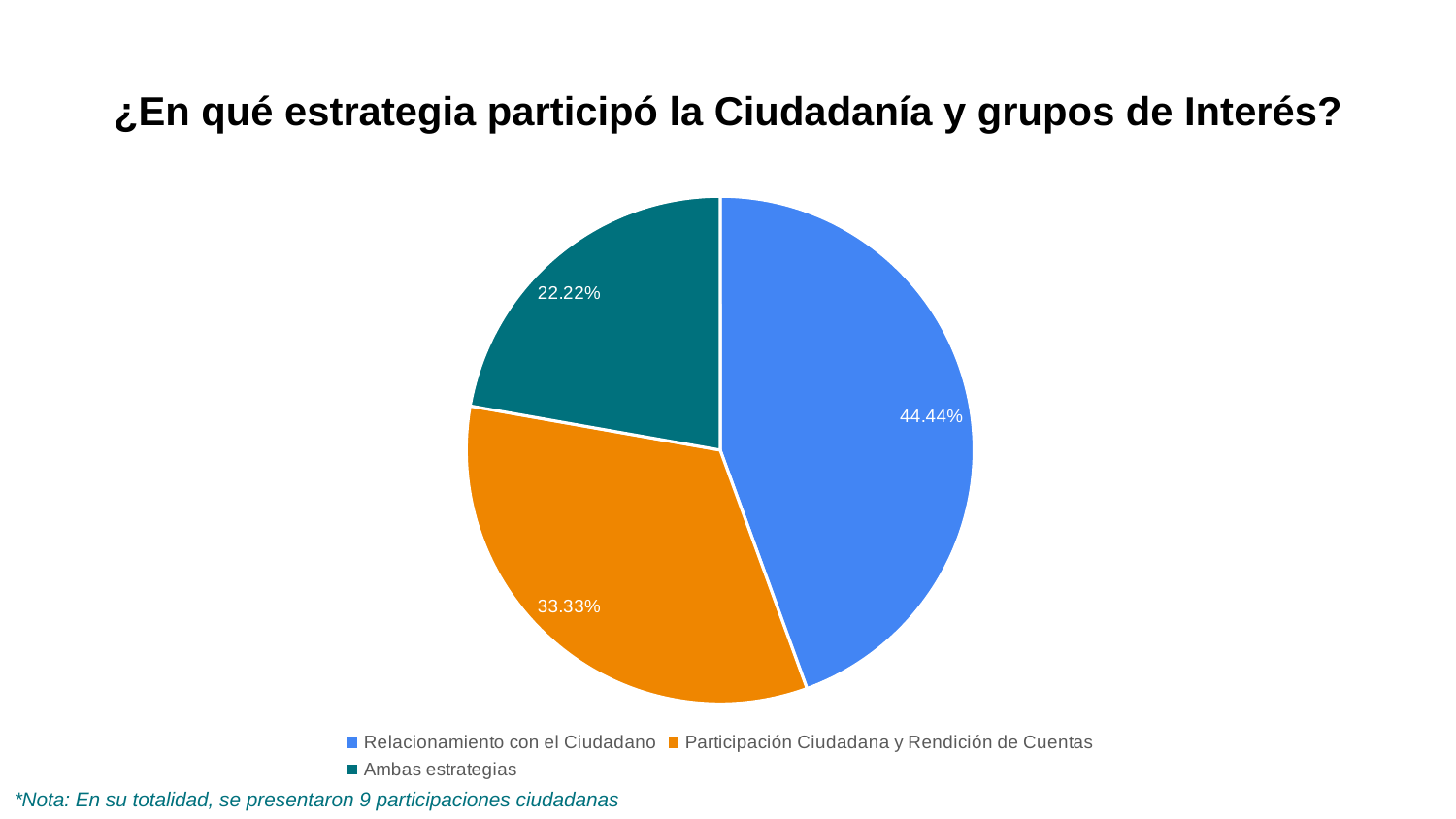
What colour is the slice for "Ambas estrategias"? Teal (dark green) How many categories does the pie chart show? 3 What share of the pie does "Relacionamiento con el Ciudadano" represent? 44.44% What is the difference in percentage points between "Relacionamiento con el Ciudadano" and "Ambas estrategias"? 22.22 What is the title of the chart? ¿En qué estrategia participó la Ciudadanía y grupos de Interés? What is the difference in percentage points between "Participación Ciudadana y Rendición de Cuentas" and "Ambas estrategias"? 11.11 What share of the pie does "Participación Ciudadana y Rendición de Cuentas" represent? 33.33% What share of the pie does "Ambas estrategias" represent? 22.22% Which is larger: the slice for "Participación Ciudadana y Rendición de Cuentas" or the slice for "Ambas estrategias"? Participación Ciudadana y Rendición de Cuentas Which category has the largest slice of the pie? Relacionamiento con el Ciudadano Which category has the smallest slice of the pie? Ambas estrategias What kind of chart is shown on the slide? Pie chart